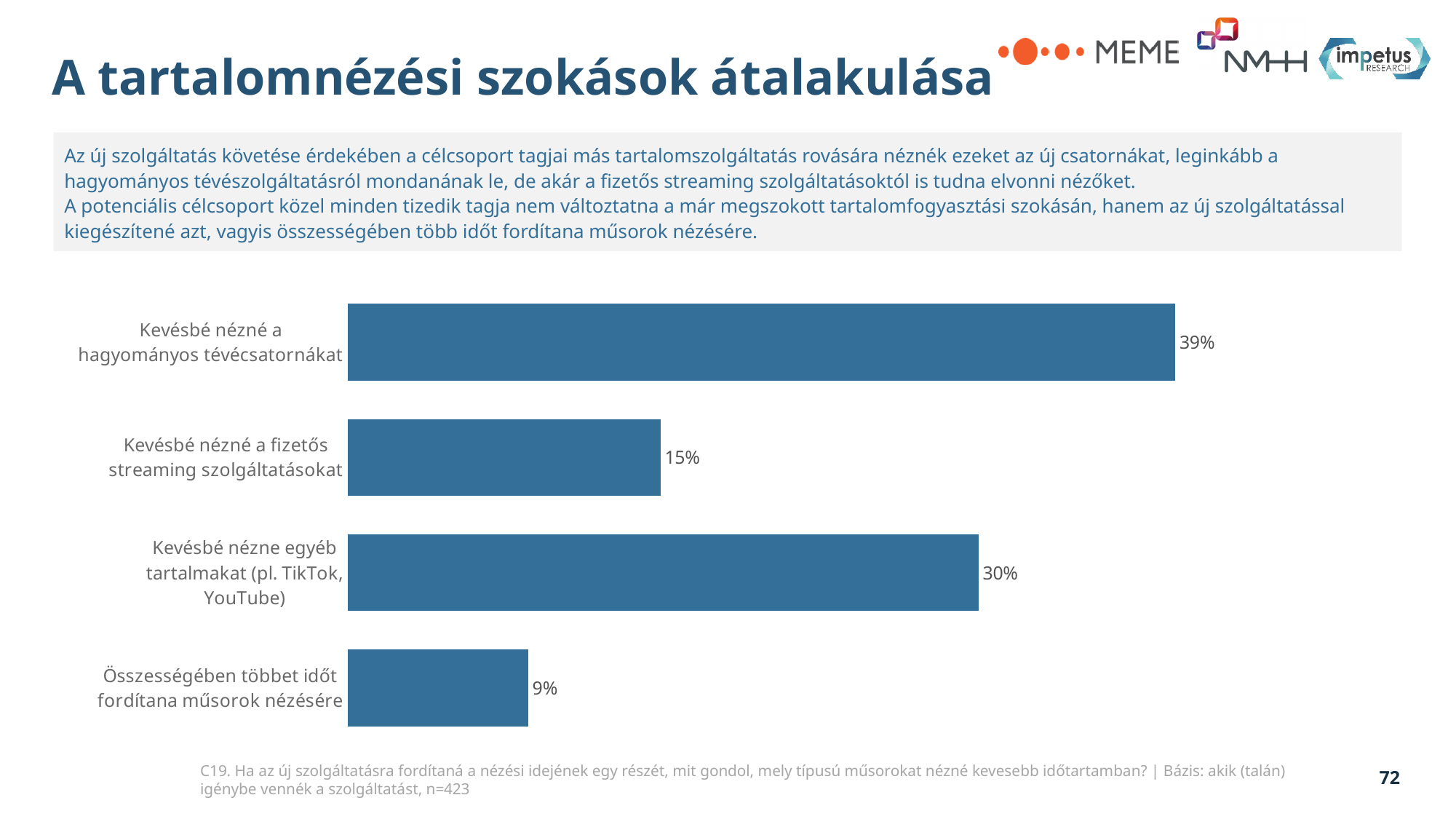
What is the value for "Kevésbé nézné a fizetős streaming szolgáltatásokat"? 15% How many categories are shown in the chart? 4 Which category has the lowest value? Összességében többet időt fordítana műsorok nézésére What is the value for "Kevésbé nézné a hagyományos tévécsatornákat"? 39% What is the difference between the values for "Kevésbé nézné a hagyományos tévécsatornákat" and "Kevésbé nézne egyéb tartalmakat (pl. TikTok, YouTube)"? 9% What is the value for "Összességében többet időt fordítana műsorok nézésére"? 9% What is the difference between the values for "Kevésbé nézné a fizetős streaming szolgáltatásokat" and "Összességében többet időt fordítana műsorok nézésére"? 6% Which category has the highest value? Kevésbé nézné a hagyományos tévécsatornákat What is the sample size (n) stated in the source note below the chart? n=423 What is the value for "Kevésbé nézne egyéb tartalmakat (pl. TikTok, YouTube)"? 30% Which is larger: the value for "Kevésbé nézné a fizetős streaming szolgáltatásokat" or for "Kevésbé nézne egyéb tartalmakat (pl. TikTok, YouTube)"? Kevésbé nézne egyéb tartalmakat (pl. TikTok, YouTube) What kind of chart is shown on the slide? Bar chart